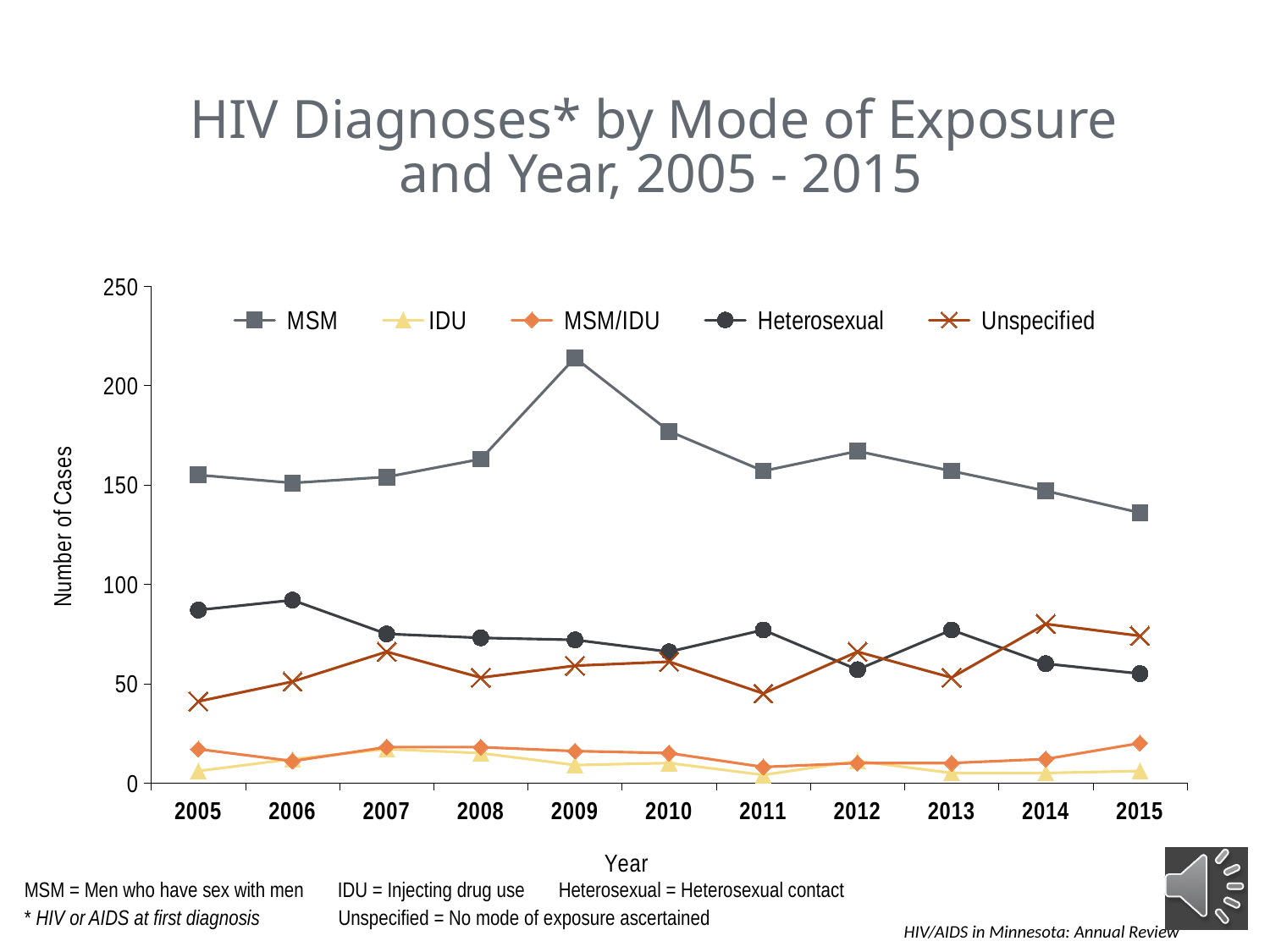
Is the Heterosexual value for 2006 greater or less than 100? less What kind of chart is shown on the slide? line chart How many series does the legend list? 5 In 2014, which is larger: the Unspecified value or the Heterosexual value? Unspecified Which series has the lowest value in 2015? IDU Does the MSM series rise or fall from 2012 to 2015? fall How many years are plotted along the x axis? 11 In 2005, which is larger: the Heterosexual value or the Unspecified value? Heterosexual Is the MSM value for 2015 greater or less than 150? less In which year does the MSM series reach its highest value? 2009 Is the MSM value for 2009 greater or less than 200? greater What is the label on the y axis? Number of Cases